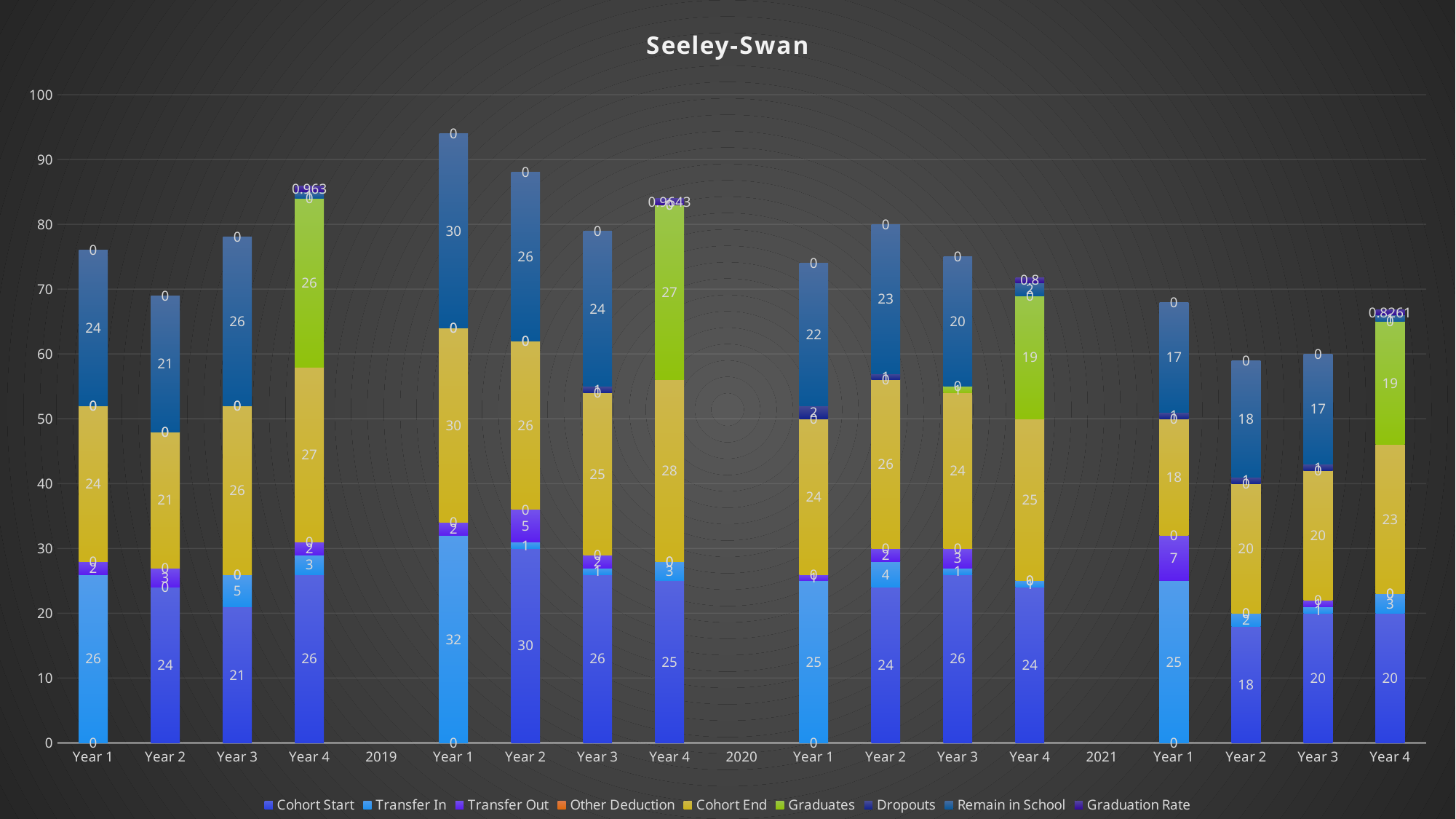
What is the Graduation Rate label shown above the second Year 4 bar from the left? 0.9643 What is the Transfer In value in the second Year 1 bar from the left? 32 Is the total height of the second Year 1 bar from the left greater or less than 90? greater Is the Cohort End value larger in the second Year 1 bar from the left or in the rightmost Year 1 bar? The second Year 1 bar from the left (30 vs 18) What type of chart is shown on the slide? Stacked bar chart How many series does the legend list? 9 What is the Graduation Rate label shown above the first Year 4 bar from the left? 0.963 Which Year 4 bar has the highest Graduates value? The second Year 4 bar from the left (27) What is the Graduation Rate label shown above the rightmost Year 4 bar? 0.8261 What is the difference between the Graduates values of the second Year 4 bar (27) and the rightmost Year 4 bar (19)? 8 What is the Graduates value in the second Year 4 bar from the left? 27 What is the title of the chart? Seeley-Swan